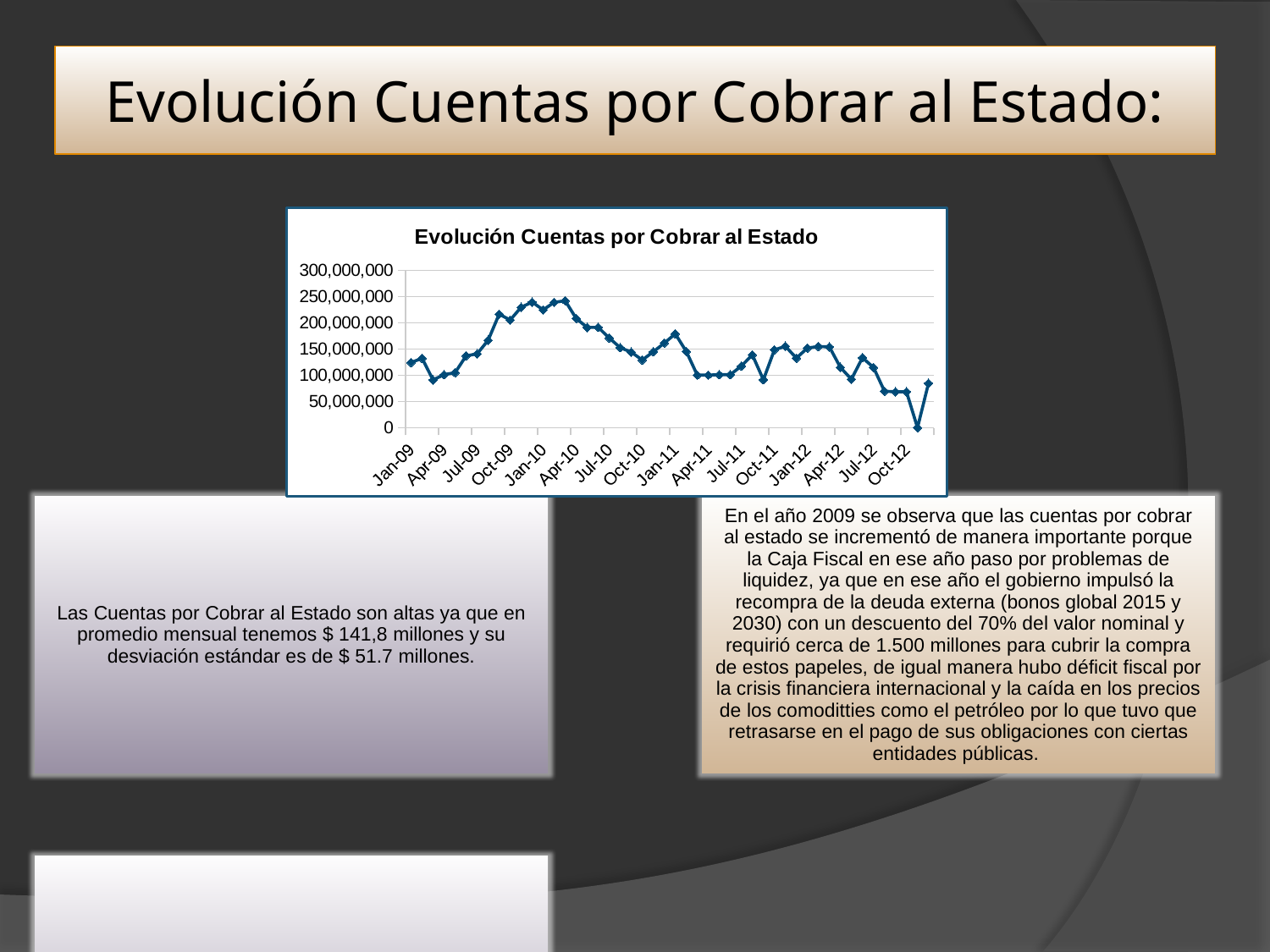
What is the title of the chart? Evolución Cuentas por Cobrar al Estado Is the value for Jan-10 greater or less than 200,000,000? greater Do the values rise or fall between Apr-09 and Jan-10? rise In which year does the series reach its lowest value? 2012 Is the value for Oct-10 greater or less than 150,000,000? less Is the peak value of the series greater or less than 200,000,000? greater How many labelled tick marks are shown on the x axis of the chart? 16 What is the highest value shown on the y axis of the chart? 300,000,000 Do the values rise or fall between Jan-10 and Oct-10? fall What kind of chart is shown on the slide? line chart